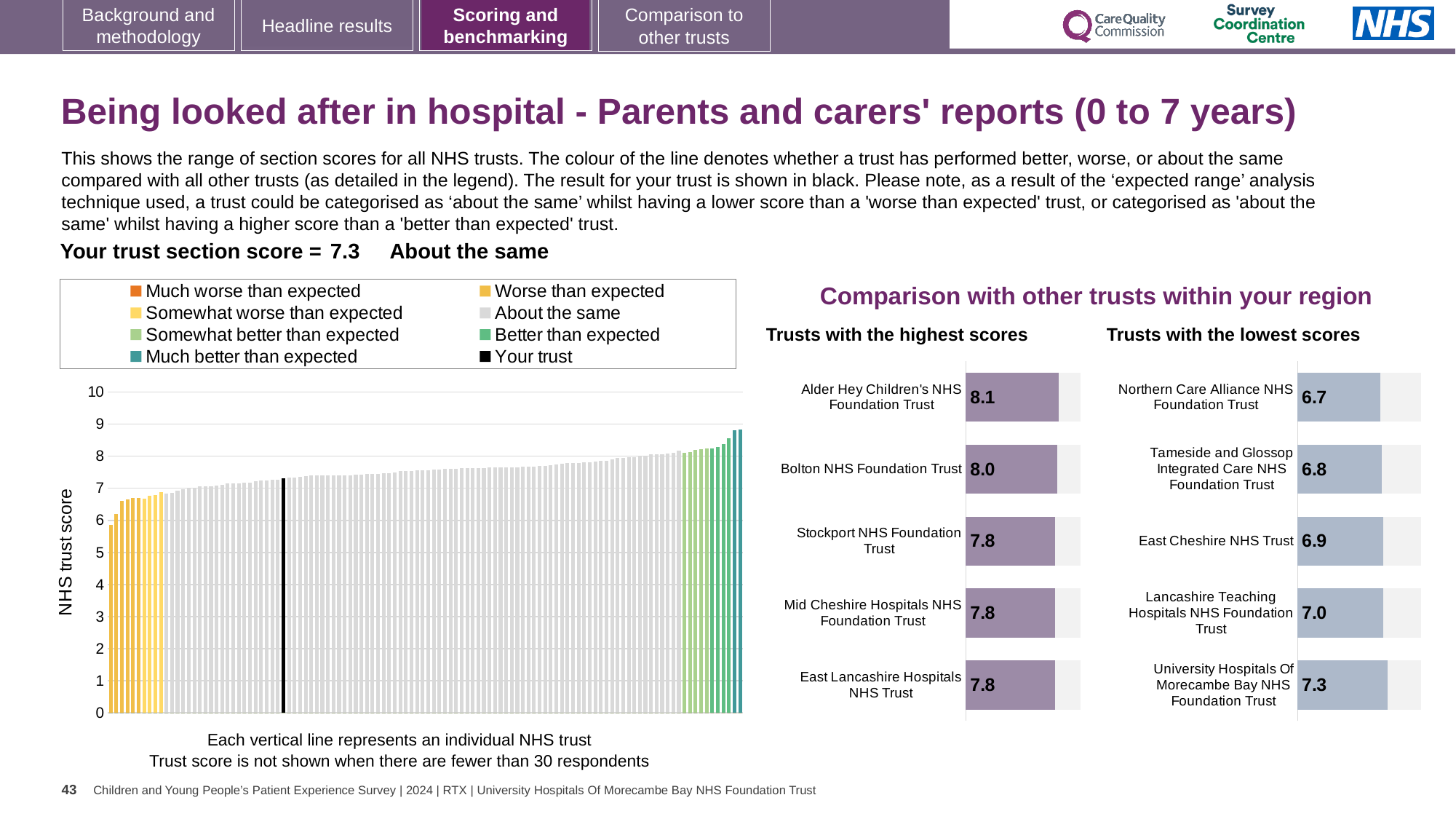
In the 'Trusts with the highest scores' chart, which trust has the highest score? Alder Hey Children's NHS Foundation Trust In the 'Trusts with the highest scores' chart, what is the score for Alder Hey Children's NHS Foundation Trust? 8.1 In the 'Trusts with the lowest scores' chart, what is the score for University Hospitals Of Morecambe Bay NHS Foundation Trust? 7.3 In the 'Trusts with the lowest scores' chart, which trust has the lowest score? Northern Care Alliance NHS Foundation Trust In the 'Trusts with the lowest scores' chart, what is the score for Northern Care Alliance NHS Foundation Trust? 6.7 How many trusts are shown in the 'Trusts with the lowest scores' chart? 5 In the 'Trusts with the lowest scores' chart, how much higher is the score of University Hospitals Of Morecambe Bay NHS Foundation Trust than that of Northern Care Alliance NHS Foundation Trust? 0.6 What kind of chart is the main chart on the left showing all NHS trusts? Bar chart How many entries does the legend of the main chart on the left list? 8 In the 'Trusts with the highest scores' chart, which has the larger score: Bolton NHS Foundation Trust or Stockport NHS Foundation Trust? Bolton NHS Foundation Trust In the main chart on the left, do the trust scores rise or fall from left to right? Rise In the 'Trusts with the highest scores' chart, what is the difference between the scores of Alder Hey Children's NHS Foundation Trust and Bolton NHS Foundation Trust? 0.1